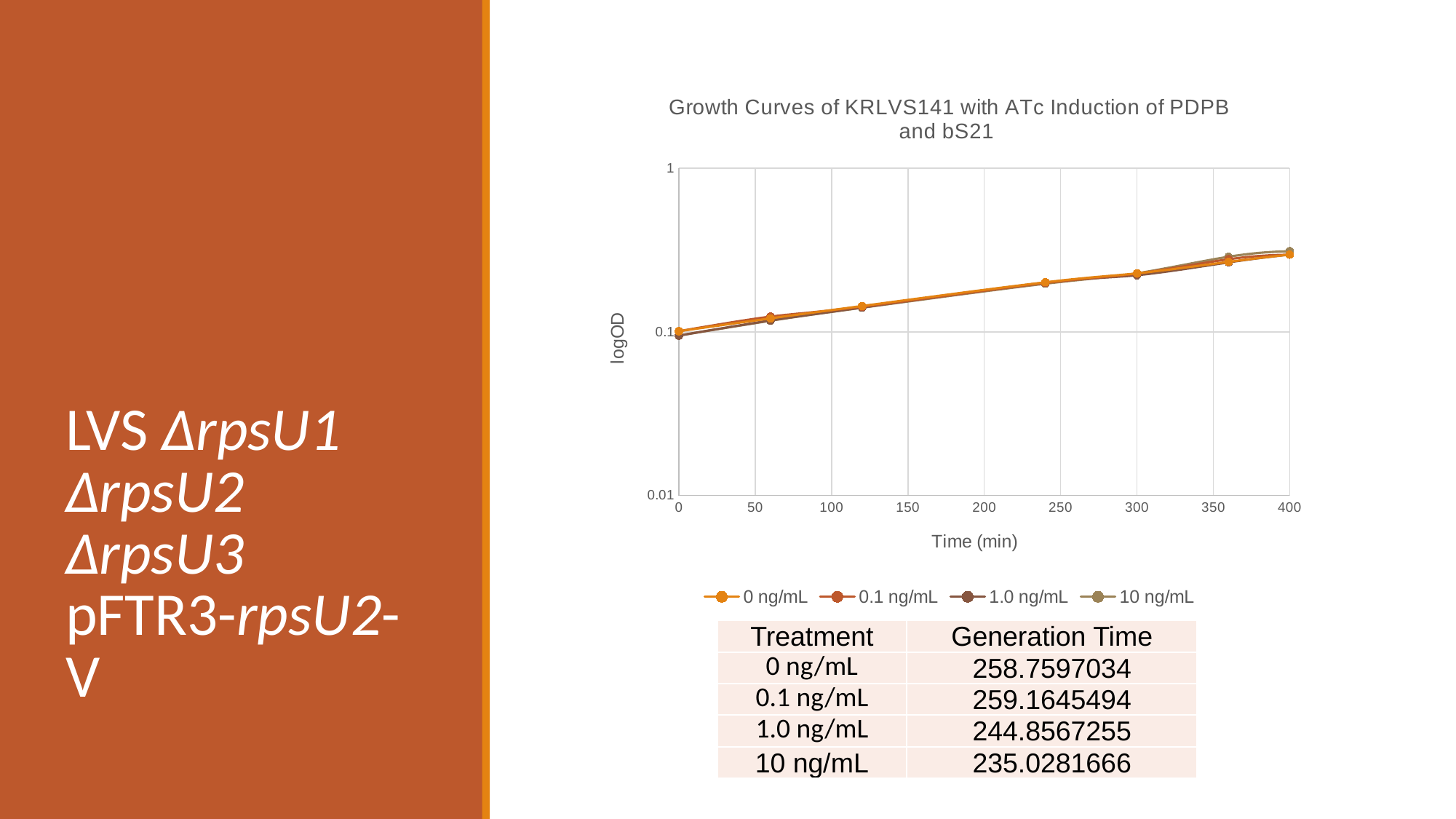
What is the label of the x axis of the chart? Time (min) Do the logOD values rise or fall as time increases along the x axis? rise How many series does the legend of the growth curve chart list? 4 How many time points are plotted for each series in the growth curve chart? 7 Is the logOD value for the 10 ng/mL series at 0 min greater or less than 1? less What is the title of the chart? Growth Curves of KRLVS141 with ATc Induction of PDPB and bS21 Is the logOD value for the 0 ng/mL series at 400 min greater or less than 0.1? greater Is the logOD value for the 1.0 ng/mL series at 240 min greater or less than 1? less What kind of chart is shown on the slide? line chart